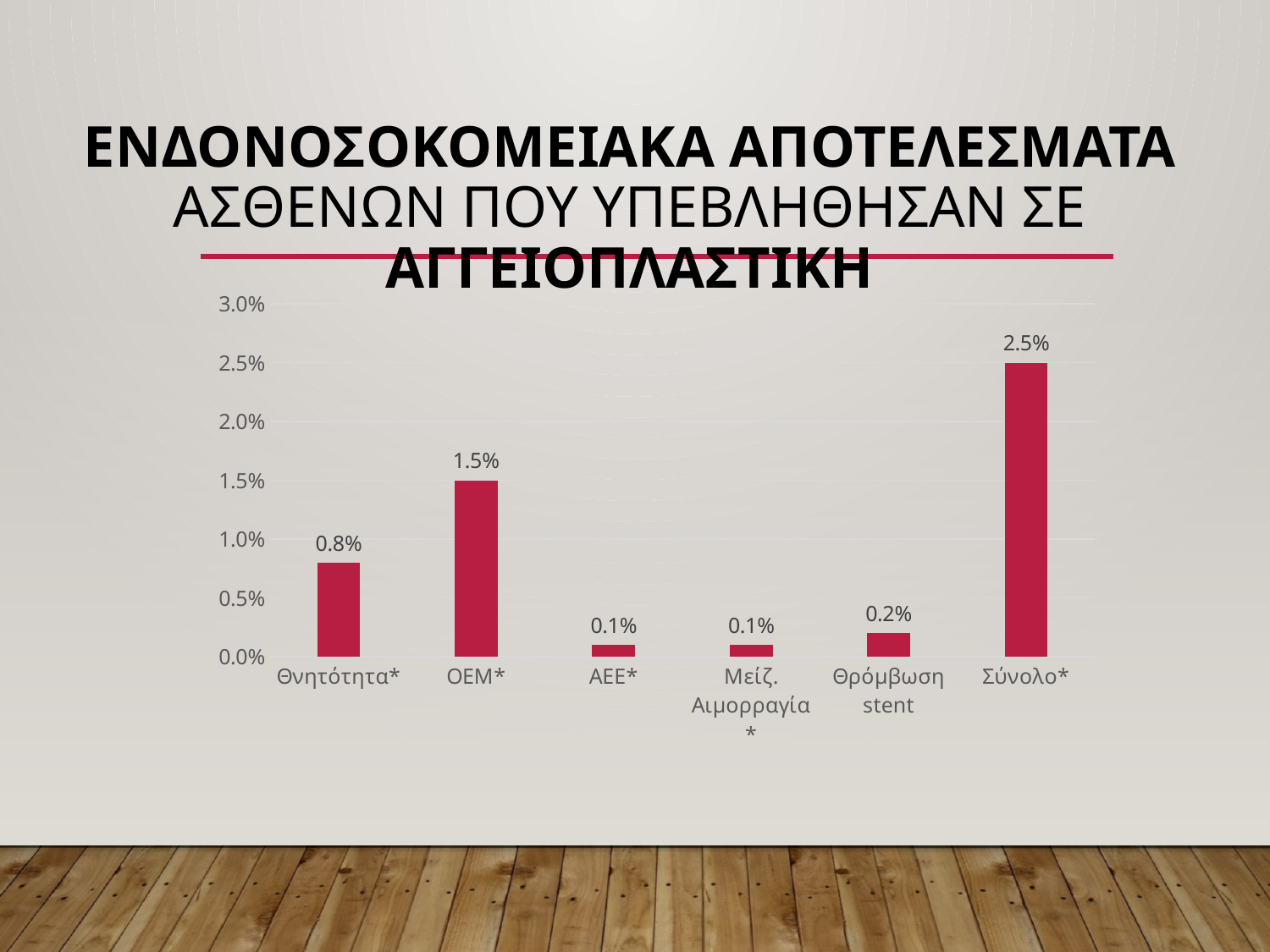
What is the value for Θρόμβωση stent? 0.2% What is the value for ΟΕΜ*? 1.5% What kind of chart is shown on the slide? bar chart What is the difference between the values for ΟΕΜ* and Θνητότητα*? 0.7% Which category has the highest value? Σύνολο* What is the value for Θνητότητα*? 0.8% Is the value for ΟΕΜ* greater or less than 1.0%? greater What is the value for Σύνολο*? 2.5% What is the difference between the values for Σύνολο* and ΟΕΜ*? 1.0% What is the value for ΑΕΕ*? 0.1% How many categories are shown on the x axis? 6 Which is larger, the value for Θνητότητα* or the value for Θρόμβωση stent? Θνητότητα*